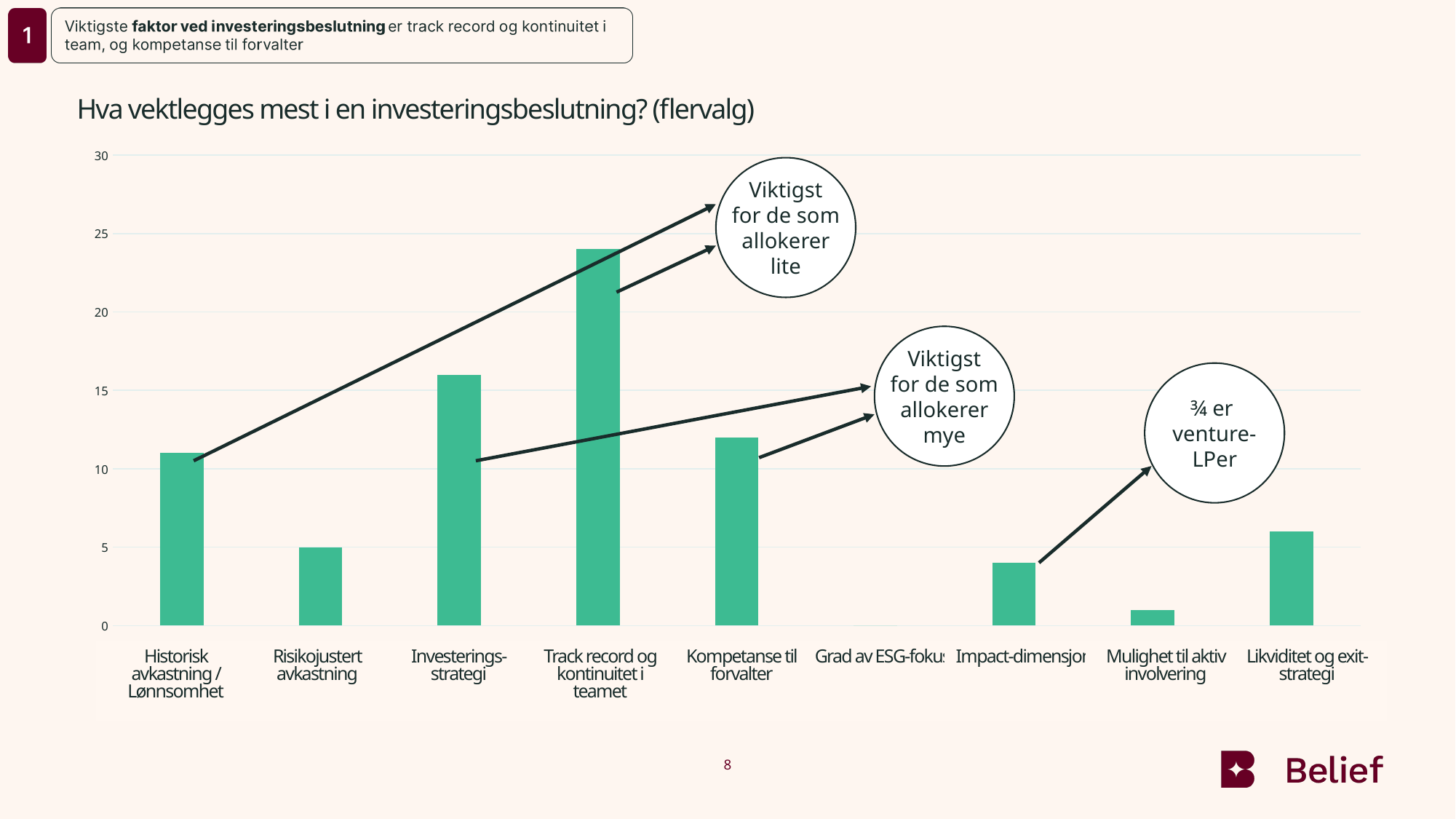
What kind of chart is shown on the slide? bar chart How many categories are shown on the x axis of the chart? 9 Which is larger, the value for Likviditet og exit-strategi or the value for Mulighet til aktiv involvering? Likviditet og exit-strategi Which category has the lowest value? Grad av ESG-fokus Which category has the highest bar? Track record og kontinuitet i teamet What is the title of the chart? Hva vektlegges mest i en investeringsbeslutning? (flervalg) Is the value for Track record og kontinuitet i teamet greater or less than 20? greater Is the value for Impact-dimensjon greater or less than 5? less Is the value for Investerings-strategi greater or less than 15? greater What is the value for Risikojustert avkastning? 5 Which is larger, the value for Investerings-strategi or the value for Kompetanse til forvalter? Investerings-strategi